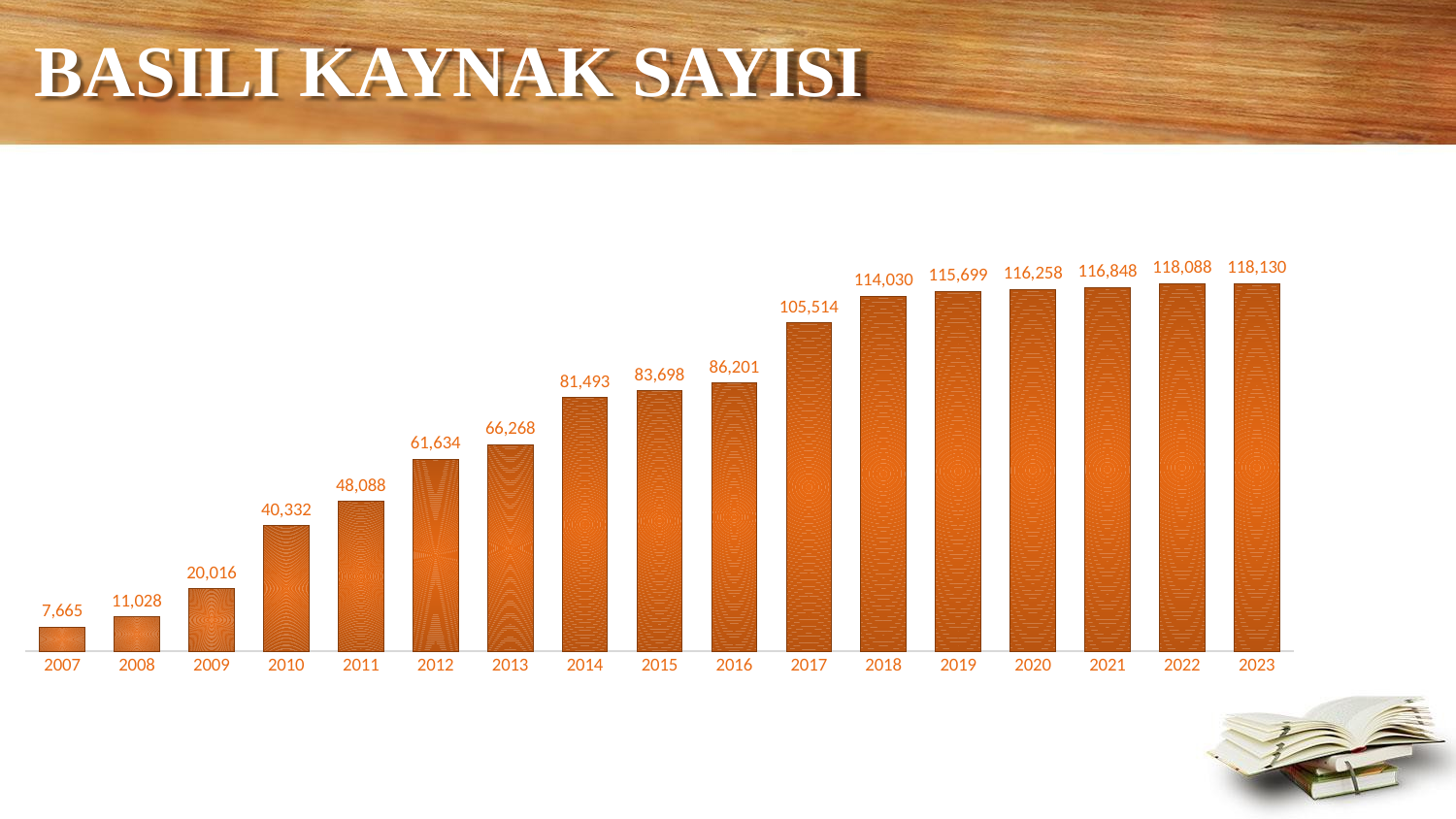
What is the value for 2007? 7,665 How many years are shown on the x axis? 17 Which year has the highest value? 2023 Which is larger, the value for 2010 or the value for 2013? 2013 What is the value for 2012? 61,634 What is the difference between the values for 2023 and 2007? 110,465 Do the values rise or fall from 2007 to 2023? rise What is the difference between the values for 2017 and 2016? 19,313 What is the title of the slide? BASILI KAYNAK SAYISI What kind of chart is this? bar chart What is the value for 2017? 105,514 Which year has the lowest value? 2007